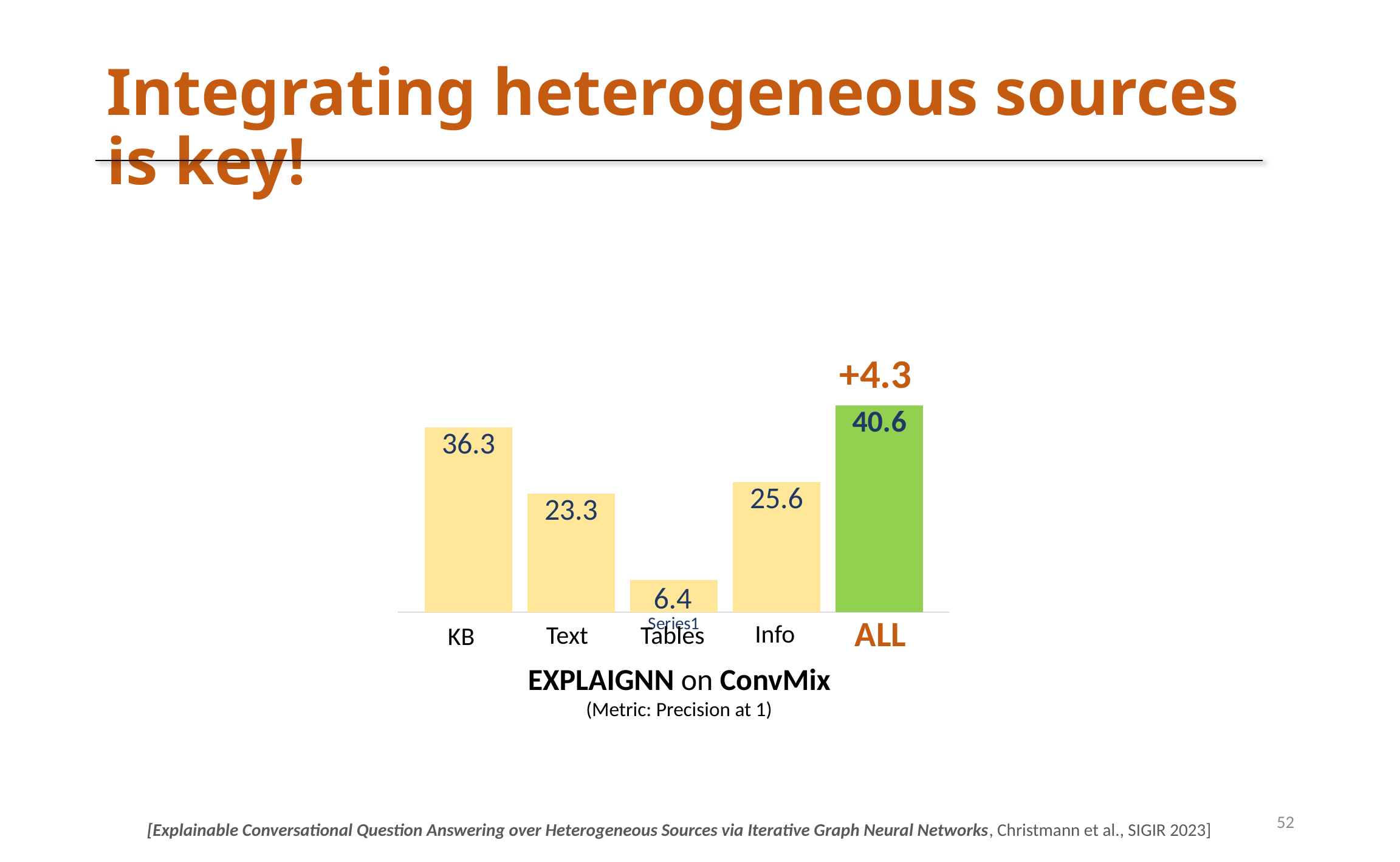
What is the value for KB? 36.3 What is the value for Tables? 6.4 Which is larger, the value for Text or the value for Info? Info Which category has the lowest value? Tables Which category has the highest value? ALL What is the value for ALL? 40.6 How many categories are shown in the chart? 5 What metric does the chart caption say is plotted? Precision at 1 What is the value for Text? 23.3 What kind of chart is shown on the slide? Bar chart What is the difference between the values for ALL and KB? 4.3 What is the value for Info? 25.6